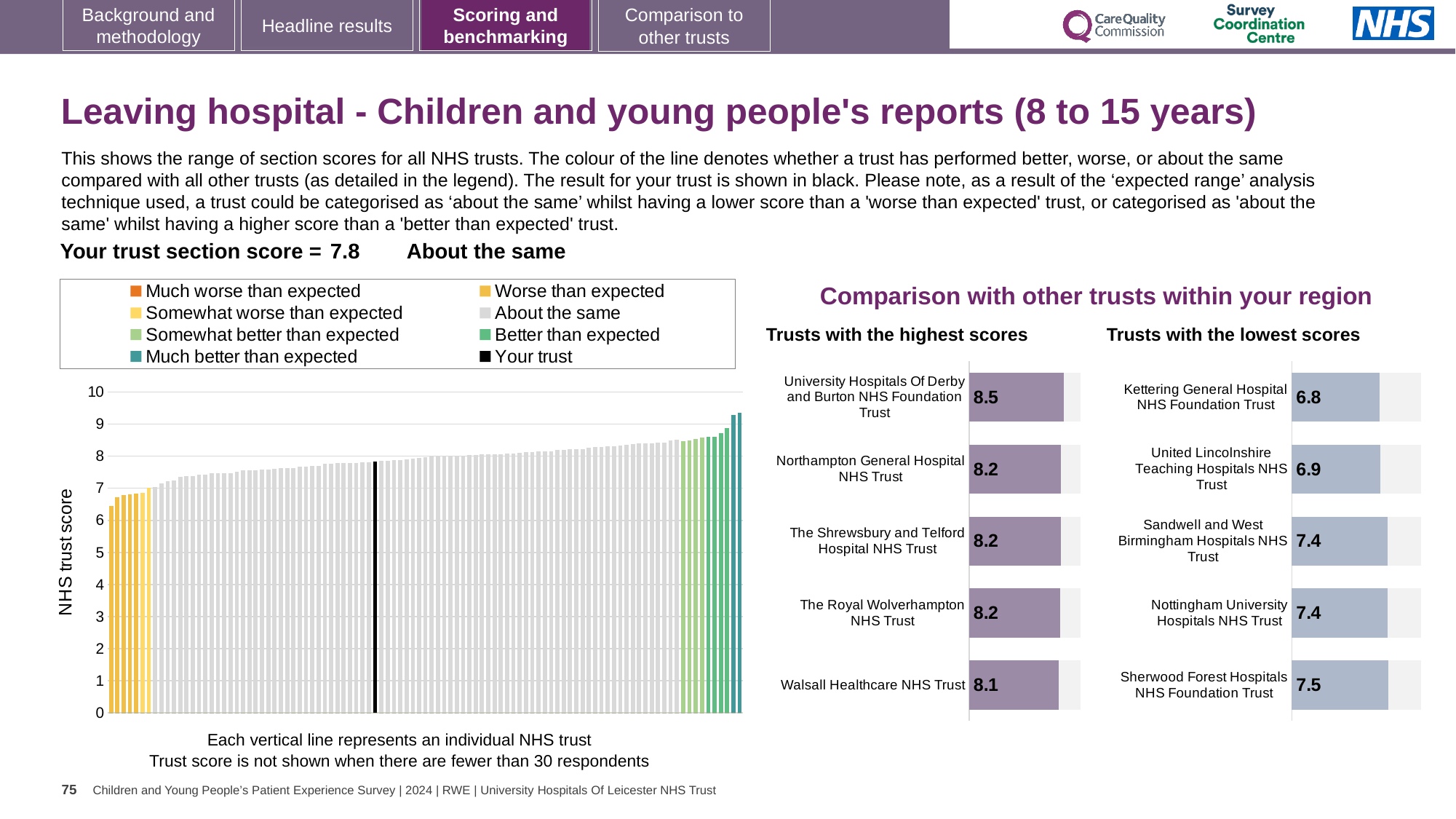
In the 'Trusts with the highest scores' chart, what is the score for Walsall Healthcare NHS Trust? 8.1 In the 'Trusts with the lowest scores' chart, which has the larger score: United Lincolnshire Teaching Hospitals NHS Trust or Sandwell and West Birmingham Hospitals NHS Trust? Sandwell and West Birmingham Hospitals NHS Trust In the 'Trusts with the lowest scores' chart, what is the score for Kettering General Hospital NHS Foundation Trust? 6.8 In the 'Trusts with the lowest scores' chart, which trust has the lowest score? Kettering General Hospital NHS Foundation Trust In the large chart on the left, do the trust scores rise or fall from left to right along the x axis? Rise In the 'Trusts with the highest scores' chart, what is the score for University Hospitals Of Derby and Burton NHS Foundation Trust? 8.5 What type of chart is the large chart on the left showing the range of section scores for all NHS trusts? Bar chart In the 'Trusts with the highest scores' chart, what is the difference between the scores of University Hospitals Of Derby and Burton NHS Foundation Trust and Walsall Healthcare NHS Trust? 0.4 In the 'Trusts with the lowest scores' chart, what is the score for Sherwood Forest Hospitals NHS Foundation Trust? 7.5 How many entries does the legend of the large chart on the left list? 8 In the 'Trusts with the highest scores' chart, which trust has the highest score? University Hospitals Of Derby and Burton NHS Foundation Trust How many trusts are shown in the 'Trusts with the lowest scores' chart? 5